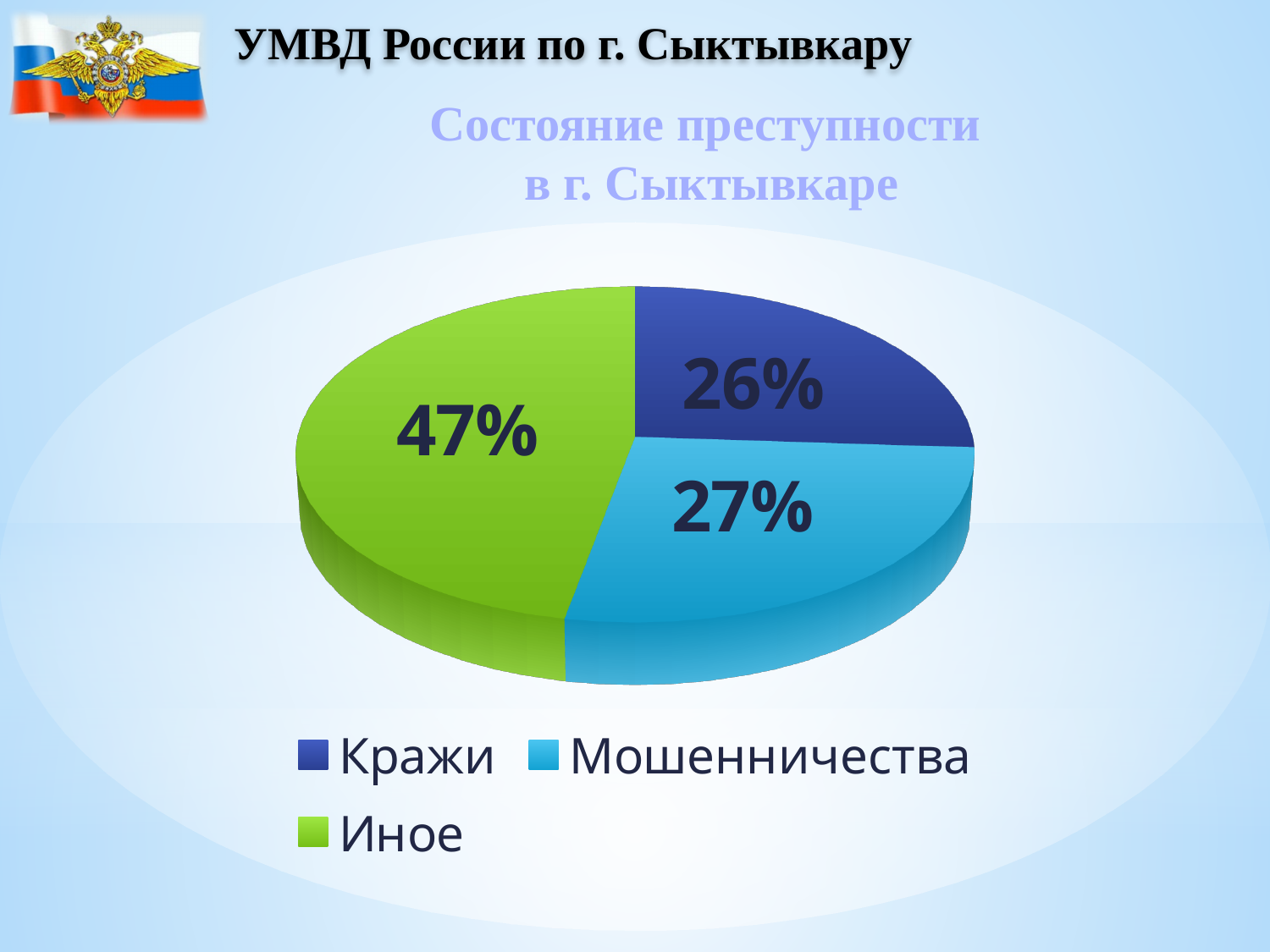
What share of the pie does Иное represent? 47% What is the title of the chart? Состояние преступности в г. Сыктывкаре What is the difference in percentage points between Мошенничества and Кражи? 1 What is the difference in percentage points between Иное and Кражи? 21 What share of the pie does Кражи represent? 26% Which category has the smallest slice of the pie? Кражи What colour is the slice for Иное? Green What share of the pie does Мошенничества represent? 27% Which is larger, the share for Мошенничества or the share for Кражи? Мошенничества How many categories are shown in the pie chart? 3 What kind of chart is shown on the slide? Pie chart Which category has the largest slice of the pie? Иное